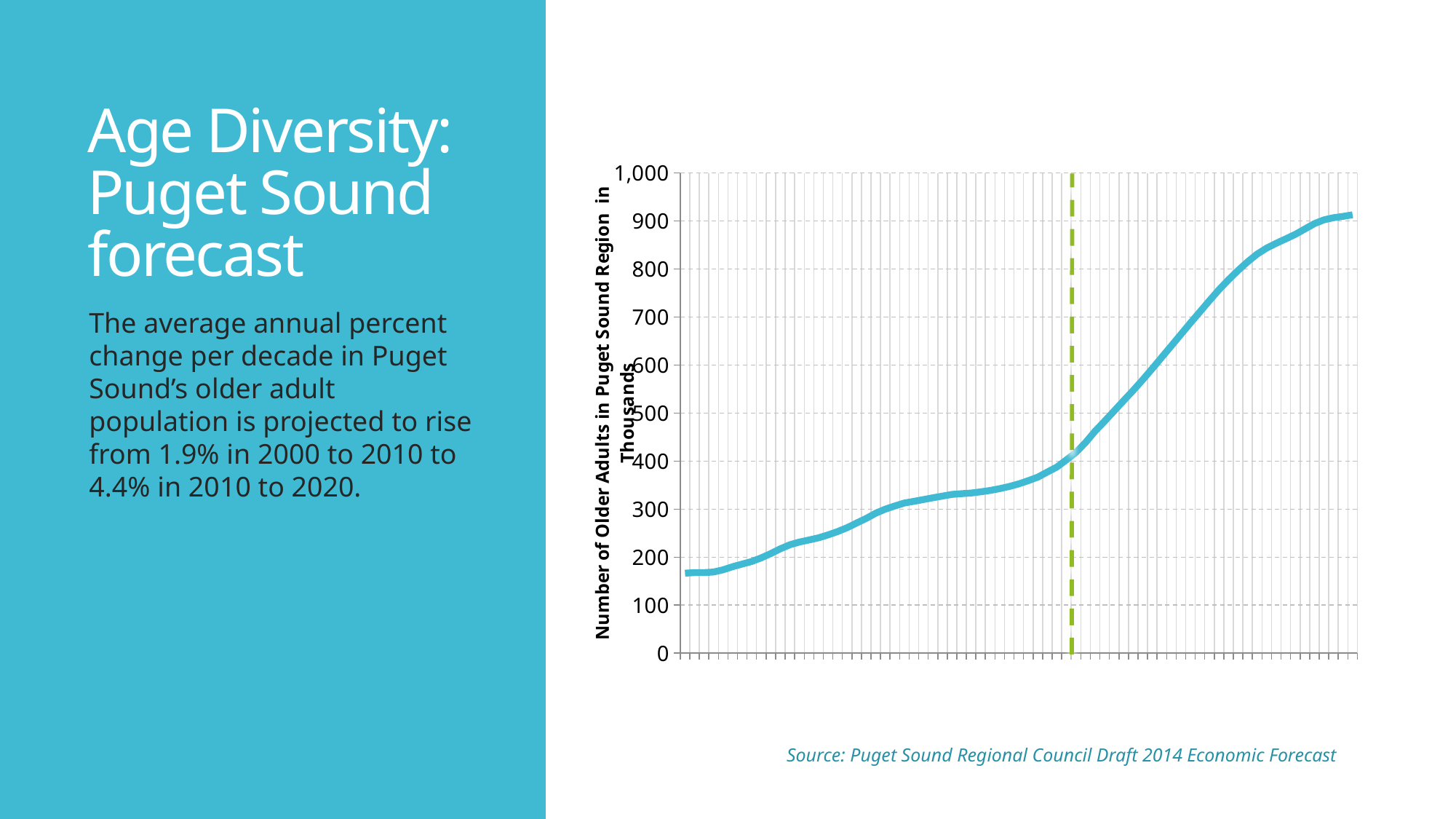
Where the line crosses the dashed green vertical line, is its value greater or less than 300? greater At which end of the chart does the line have its lowest value? the left end What is the title of the chart's vertical axis? Number of Older Adults in Puget Sound Region in Thousands How many lines (data series) are plotted on the chart? 1 What is the highest tick value shown on the chart's vertical axis? 1,000 What kind of chart is shown on the slide? line chart Do the values on the chart rise or fall from left to right along the x axis? rise Is the value at the right-most (last) point of the line greater or less than 800? greater Is the value at the left-most (first) point of the line greater or less than 200? less At which end of the chart does the line reach its highest value? the right end Which is larger, the value at the first point of the line or the value at the last point? the last point